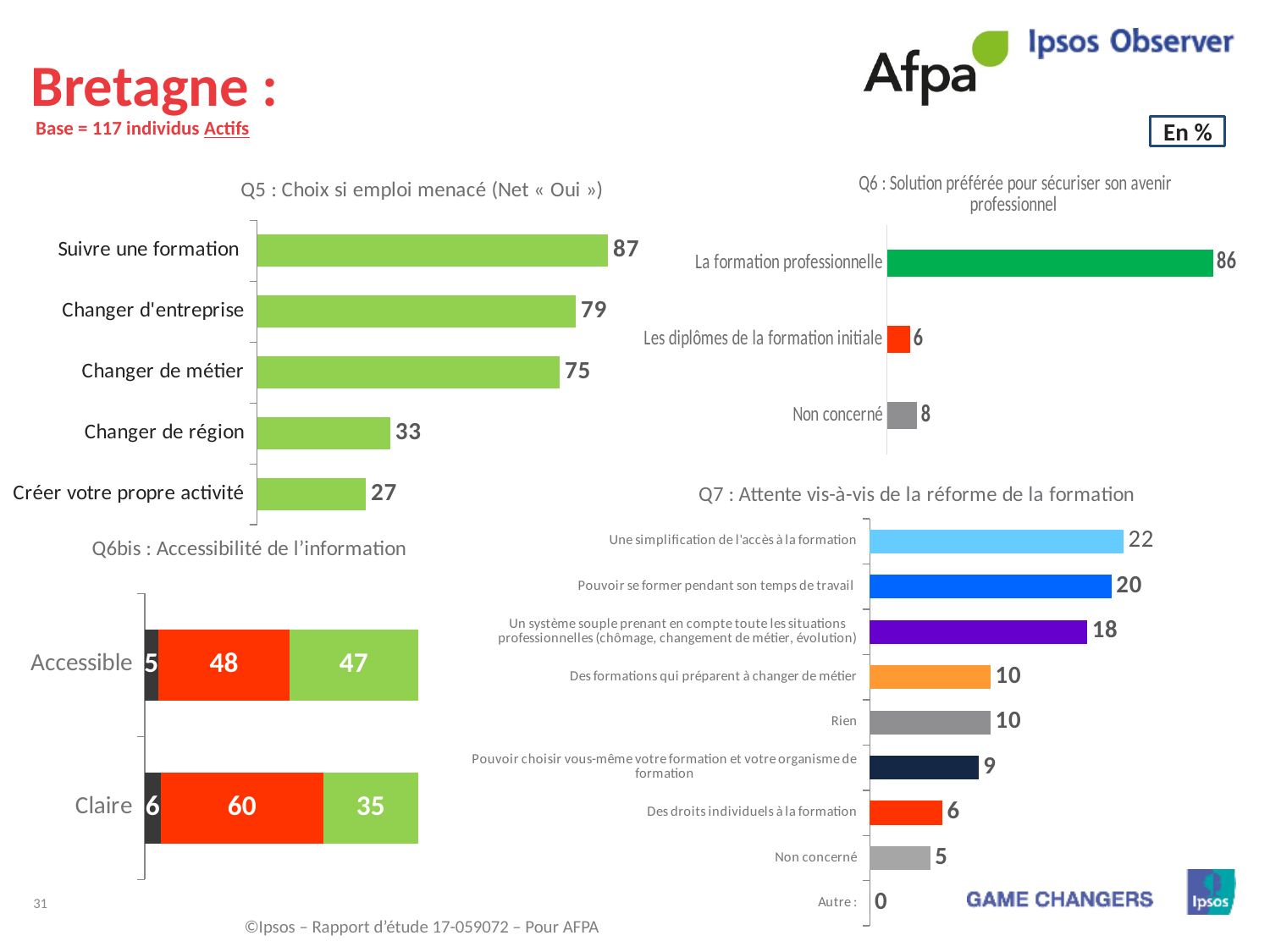
In the Q6bis chart (Accessibilité de l'information), what is the total of the stacked bar for "Claire"? 101 In the Q6bis chart (Accessibilité de l'information), what is the value of the red segment for "Accessible"? 48 In the Q5 chart (Choix si emploi menacé), what is the difference between "Changer d'entreprise" and "Changer de métier"? 4 In the Q5 chart (Choix si emploi menacé), how many categories are shown? 5 In the Q6 chart (Solution préférée pour sécuriser son avenir professionnel), what is the value for "La formation professionnelle"? 86 In the Q6 chart (Solution préférée pour sécuriser son avenir professionnel), which category has the lowest value? Les diplômes de la formation initiale In the Q5 chart (Choix si emploi menacé), which category has the highest value? Suivre une formation What kind of chart is the Q6bis chart (Accessibilité de l'information)? Stacked bar chart In the Q5 chart (Choix si emploi menacé), what is the value for "Changer de région"? 33 In the Q7 chart (Attente vis-à-vis de la réforme de la formation), what is the value for "Pouvoir se former pendant son temps de travail"? 20 In the Q7 chart (Attente vis-à-vis de la réforme de la formation), how many categories are shown? 9 In the Q7 chart (Attente vis-à-vis de la réforme de la formation), which is larger: "Des droits individuels à la formation" or "Non concerné"? Des droits individuels à la formation